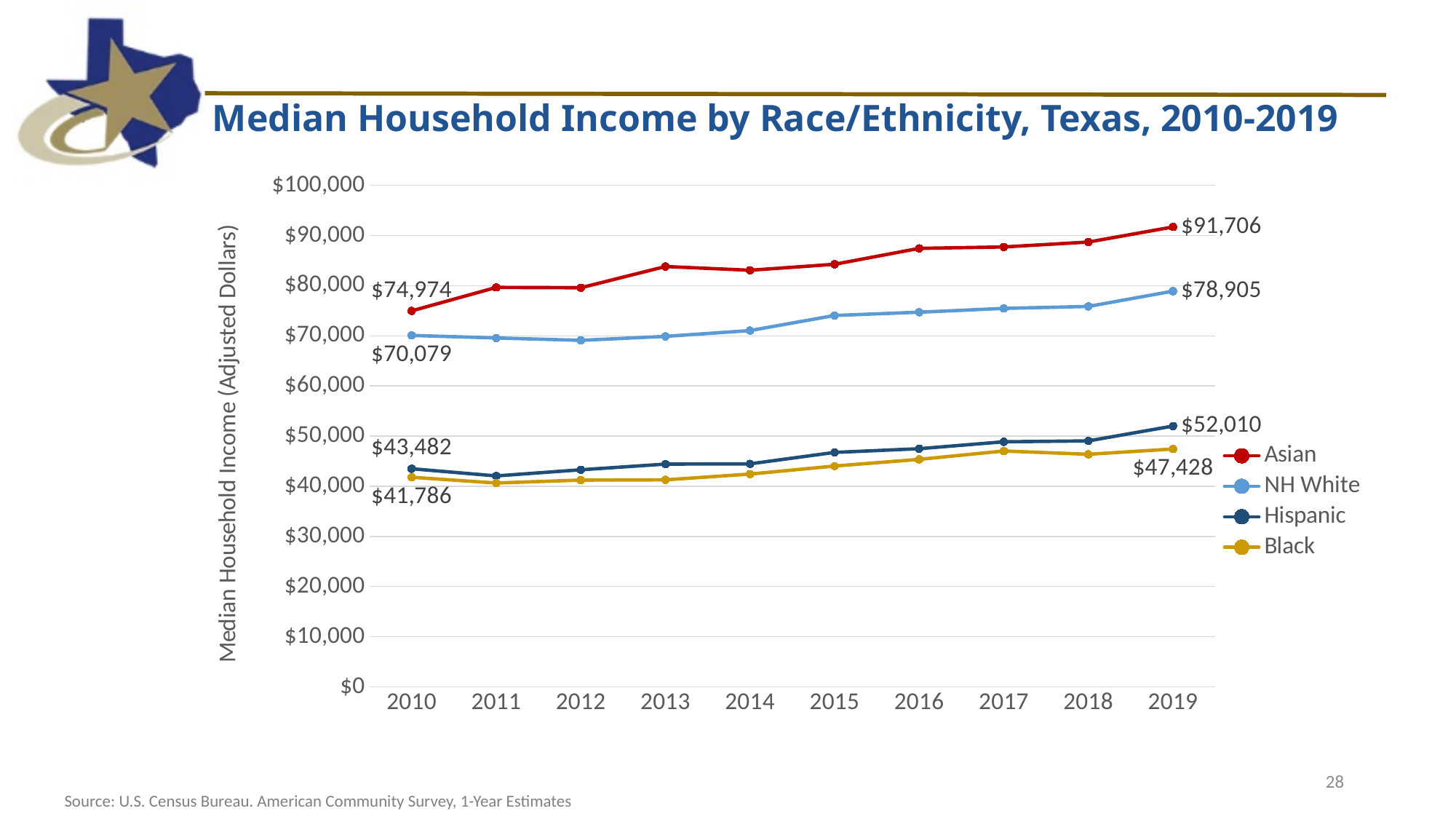
What was the median household income for Black households in 2010? $41,786 What is the difference between the 2019 median household income of Hispanic and Black households? $4,582 What type of chart is shown on the slide? Line chart What was the median household income for Asian households in Texas in 2019? $91,706 By how much did the median household income for Asian households increase from 2010 to 2019? $16,732 How many series does the legend list? 4 What was the median household income for NH White households in 2010? $70,079 In 2019, which group had a higher median household income: NH White or Hispanic? NH White Which race/ethnicity group had the lowest median household income in 2010? Black Is the median household income for Asian households in 2013 greater or less than $80,000? greater What was the median household income for Hispanic households in 2019? $52,010 Which race/ethnicity group had the highest median household income in 2019? Asian